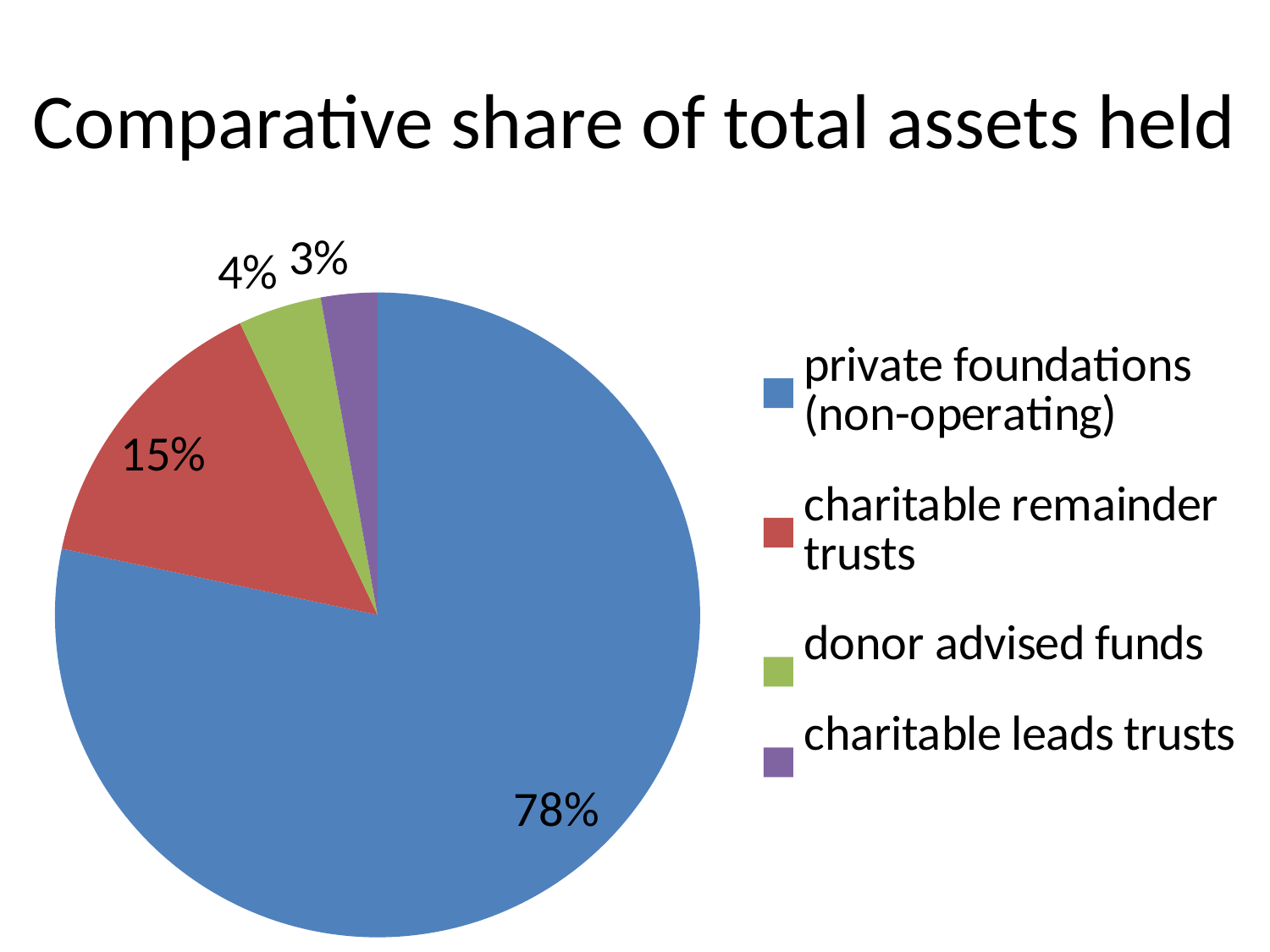
What is the difference in percentage points between the shares of private foundations (non-operating) and charitable remainder trusts? 63 Which holds a larger share of total assets, donor advised funds or charitable remainder trusts? charitable remainder trusts What share of total assets is held by private foundations (non-operating)? 78% What share of total assets is held by donor advised funds? 4% What share of total assets is held by charitable remainder trusts? 15% What kind of chart is shown on the slide? pie chart How many categories are shown in the pie chart? 4 Which category holds the smallest share of total assets? charitable leads trusts Which colour represents donor advised funds in the pie chart? green What is the title of the chart? Comparative share of total assets held What share of total assets is held by charitable leads trusts? 3% Which category holds the largest share of total assets? private foundations (non-operating)